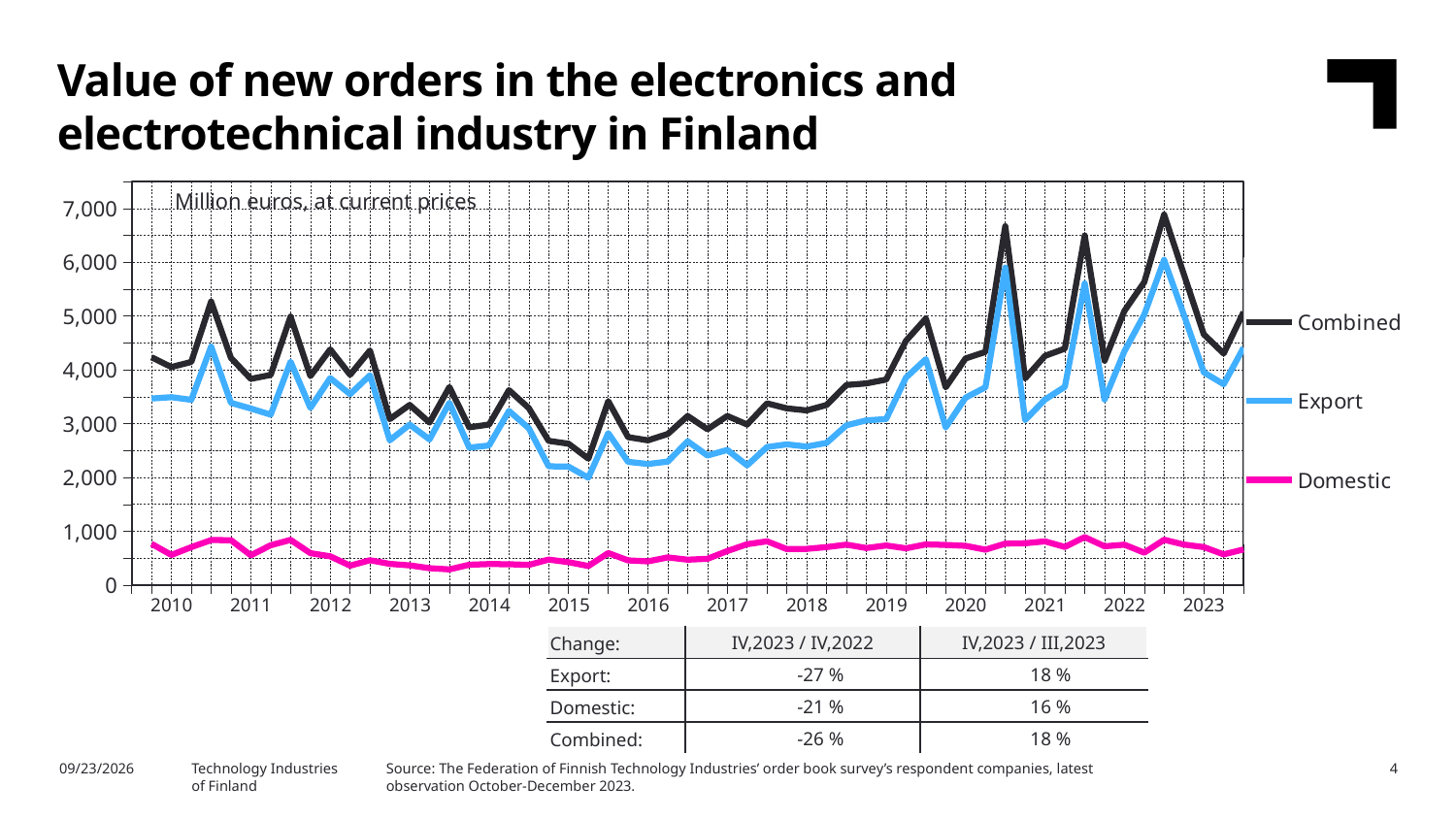
How many years are labelled on the x axis of the chart? 14 Is the Export value at the start of 2015 greater or less than 3,000? less Is the Domestic value in 2023 greater or less than 1,000? less Which series are listed in the chart's legend? Combined, Export, Domestic What kind of chart is shown on the slide? Line chart How many series does the chart's legend list? 3 In 2020, which is larger: the Export value or the Domestic value? Export Does the Combined series generally rise or fall between 2015 and 2022? rise Which series has the highest values throughout the chart? Combined Which series has the lowest values throughout the chart? Domestic What unit is stated for the values in the chart? Million euros, at current prices Is the peak Combined value in 2022 greater or less than 6,000? greater